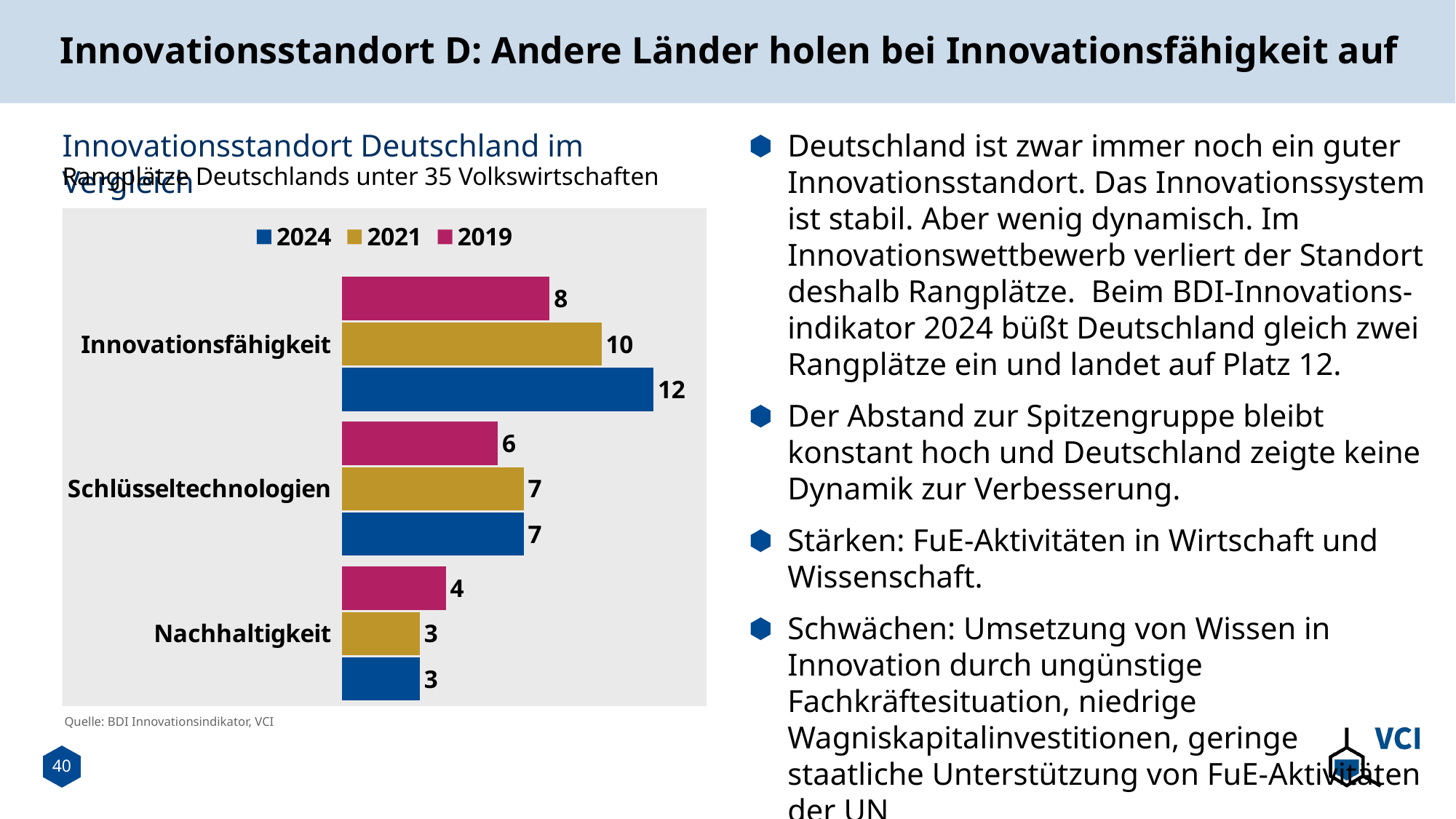
How many categories are shown in the chart? 3 What is the 2021 value for Schlüsseltechnologien? 7 Which category has the highest 2024 value? Innovationsfähigkeit How many series does the legend list? 3 What is the difference between the 2024 and 2019 values for Innovationsfähigkeit? 4 Which is larger for Nachhaltigkeit, the 2019 value or the 2021 value? 2019 What is the 2019 value for Innovationsfähigkeit? 8 What is Germany's 2024 rank for Innovationsfähigkeit? 12 What source is cited below the chart? BDI Innovationsindikator, VCI What is the 2024 value for Nachhaltigkeit? 3 What type of chart is shown on the slide? Bar chart Which category has the lowest 2019 value? Nachhaltigkeit